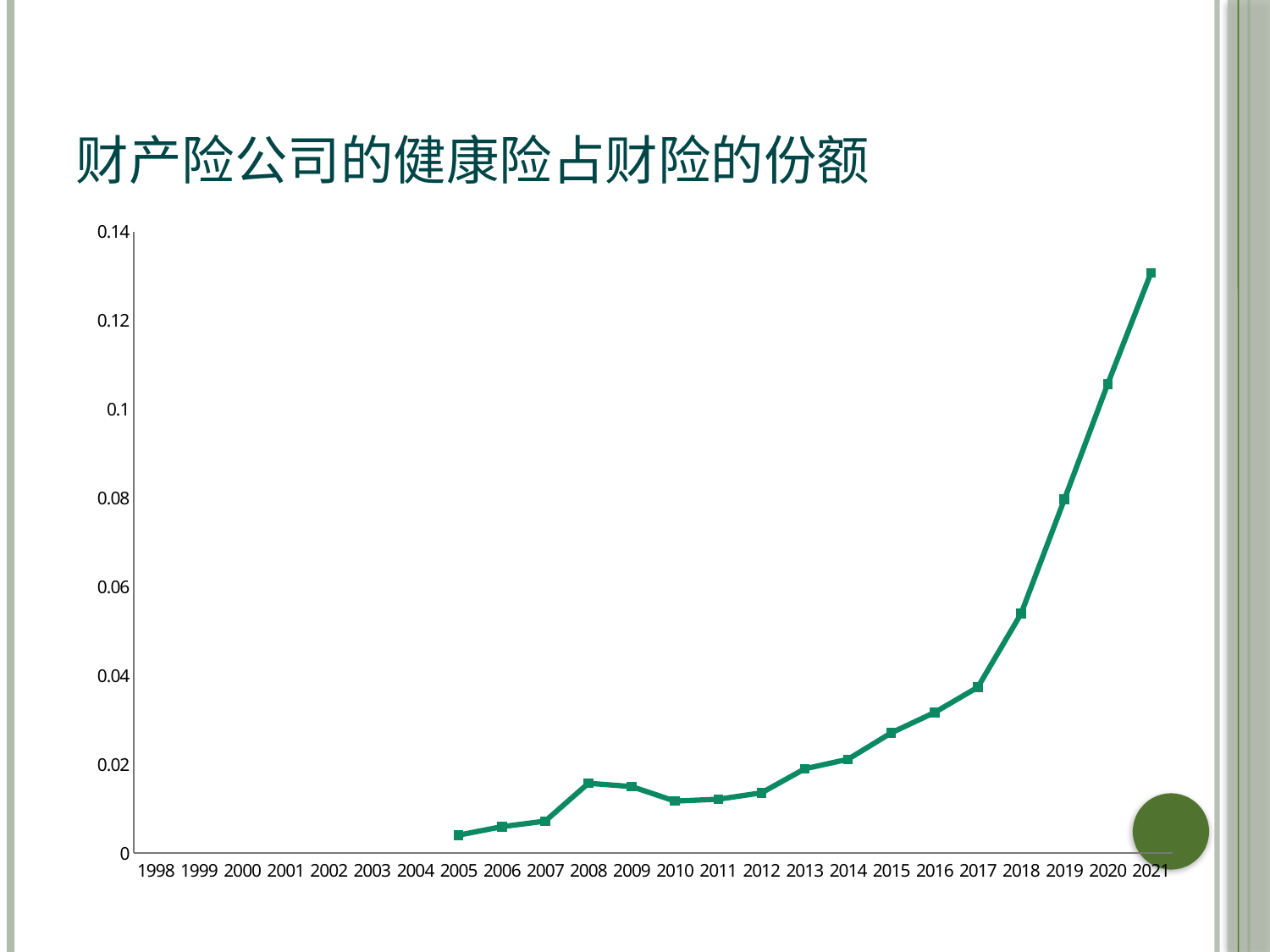
Is the value for 2020 greater or less than 0.1? greater Is the value for 2015 greater or less than 0.02? greater What is the title of the chart? 财产险公司的健康险占财险的份额 Overall, do the values rise or fall from 2005 to 2021? rise Is the value for 2008 greater or less than 0.02? less Which is larger, the value for 2008 or the value for 2010? 2008 How many data points are plotted on the line? 17 Which year has the highest value on the chart? 2021 Which year has the lowest plotted value on the chart? 2005 What kind of chart is shown on the slide? line chart